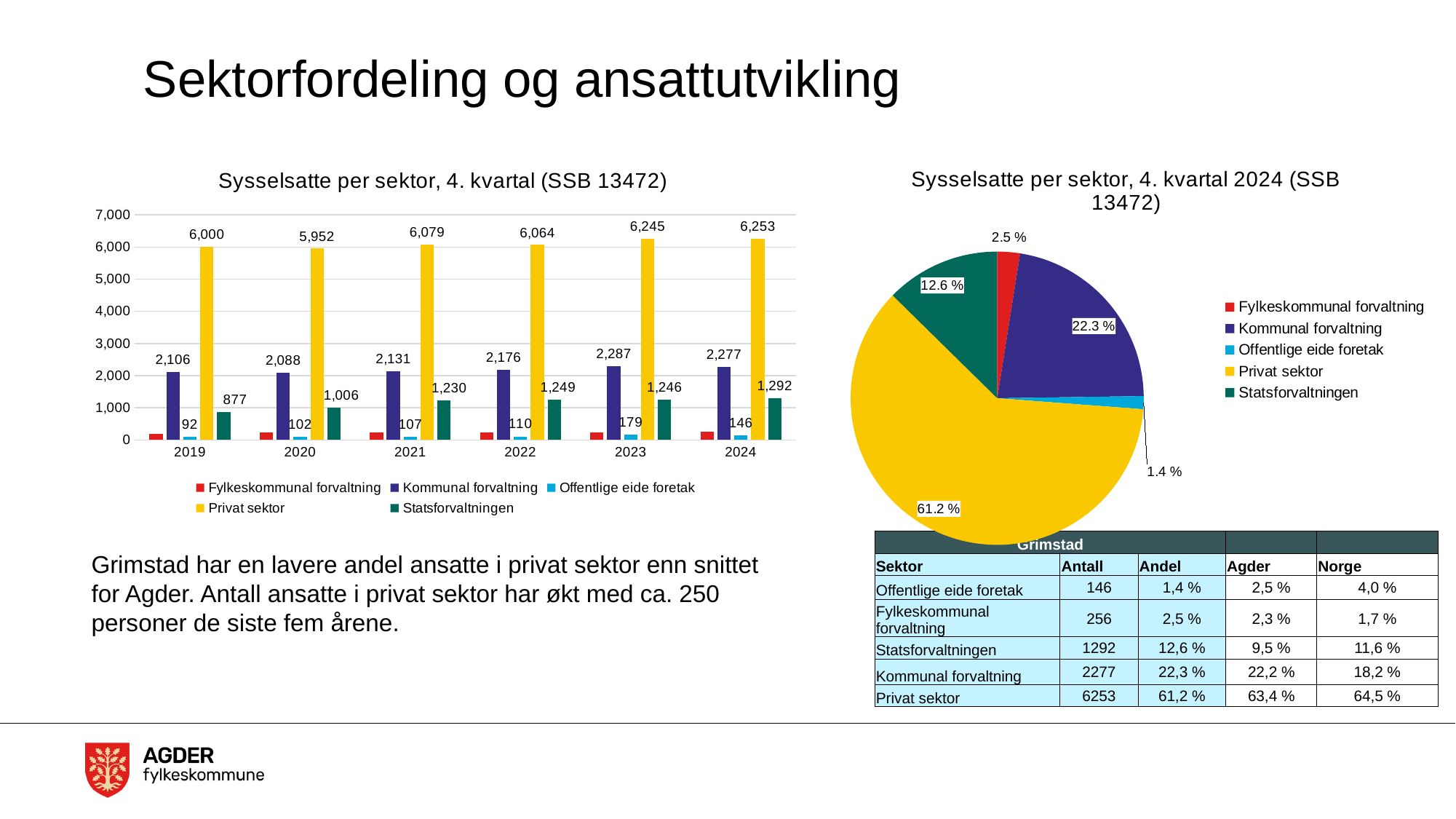
What kind of chart is 'Sysselsatte per sektor, 4. kvartal (SSB 13472)' on the left of the slide? bar chart In the bar chart 'Sysselsatte per sektor, 4. kvartal (SSB 13472)', how many years are shown on the x axis? 6 In the bar chart 'Sysselsatte per sektor, 4. kvartal (SSB 13472)', is the Kommunal forvaltning value for 2022 larger or smaller than the Statsforvaltningen value for 2022? larger In the bar chart 'Sysselsatte per sektor, 4. kvartal (SSB 13472)', what is the value for Privat sektor in 2024? 6,253 In the bar chart 'Sysselsatte per sektor, 4. kvartal (SSB 13472)', which year has the highest value for Kommunal forvaltning? 2023 In the pie chart 'Sysselsatte per sektor, 4. kvartal 2024 (SSB 13472)', which sector has the smallest slice? Offentlige eide foretak In the bar chart 'Sysselsatte per sektor, 4. kvartal (SSB 13472)', how many series does the legend list? 5 In the pie chart 'Sysselsatte per sektor, 4. kvartal 2024 (SSB 13472)', what share does Privat sektor have? 61.2 % In the bar chart 'Sysselsatte per sektor, 4. kvartal (SSB 13472)', what is the value for Statsforvaltningen in 2019? 877 In the bar chart 'Sysselsatte per sektor, 4. kvartal (SSB 13472)', which year has the lowest value for Privat sektor? 2020 In the bar chart 'Sysselsatte per sektor, 4. kvartal (SSB 13472)', what is the difference between the Privat sektor values for 2024 and 2019? 253 In the bar chart 'Sysselsatte per sektor, 4. kvartal (SSB 13472)', what is the value for Offentlige eide foretak in 2023? 179